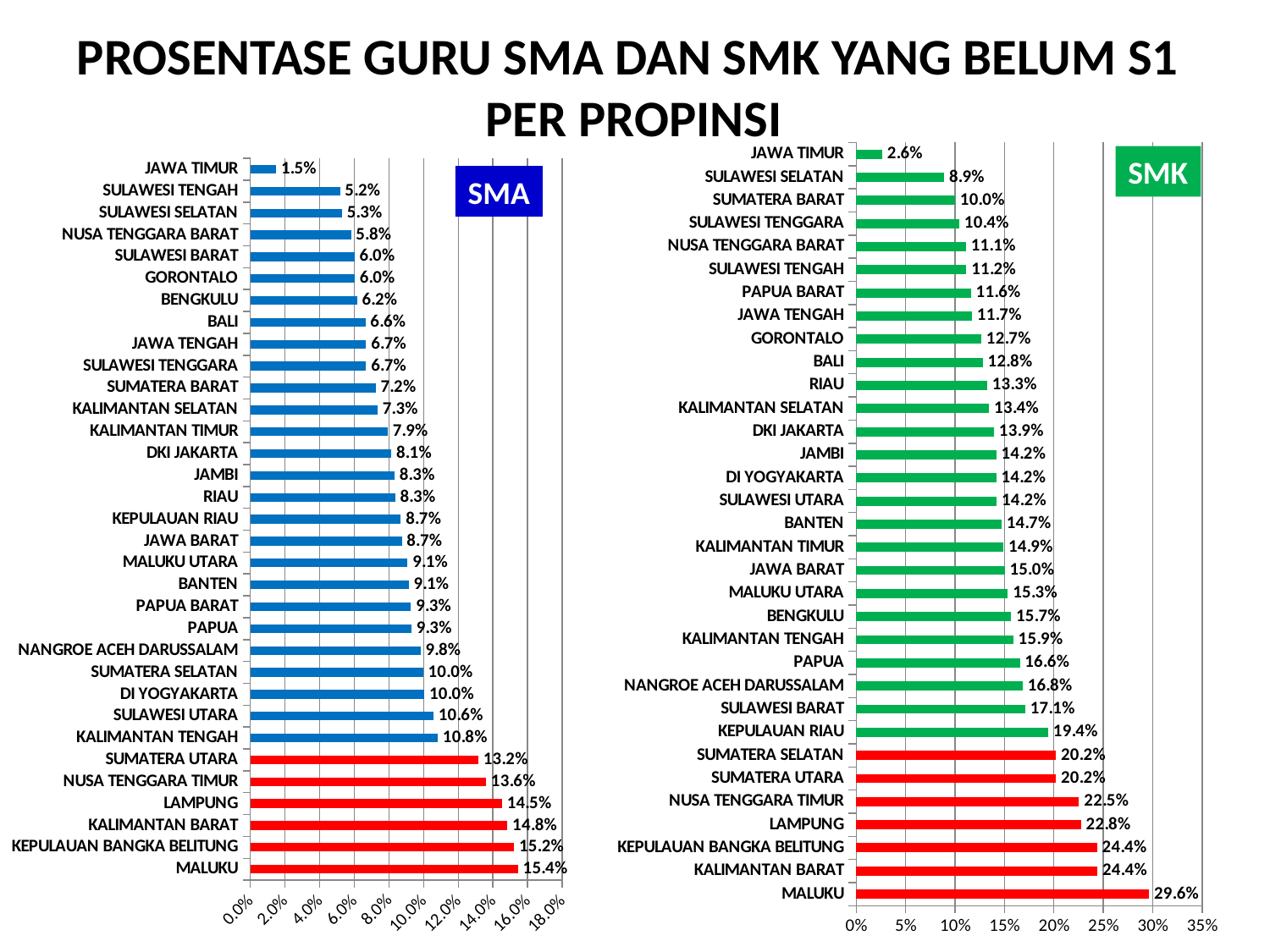
In the SMA chart, what is the value for Jawa Timur? 1.5% In the SMA chart, which province has the highest value? Maluku In the SMK chart, which province has the lowest value? Jawa Timur In the SMA chart, what is the difference between Sumatera Utara and Kalimantan Tengah? 2.4% What colour are the bars for the six highest provinces in the SMA chart? red In the SMA chart, is the value for Kalimantan Barat greater or less than 12.0%? greater How many provinces are shown in the SMK chart? 33 In the SMK chart, what is the difference between Maluku and Kalimantan Barat? 5.2% What kind of chart is the SMA chart? bar chart In the SMK chart, what is the value for Maluku? 29.6% In the SMK chart, which is larger, the value for Lampung or the value for Nusa Tenggara Timur? Lampung In the SMK chart, what is the value for Kepulauan Riau? 19.4%